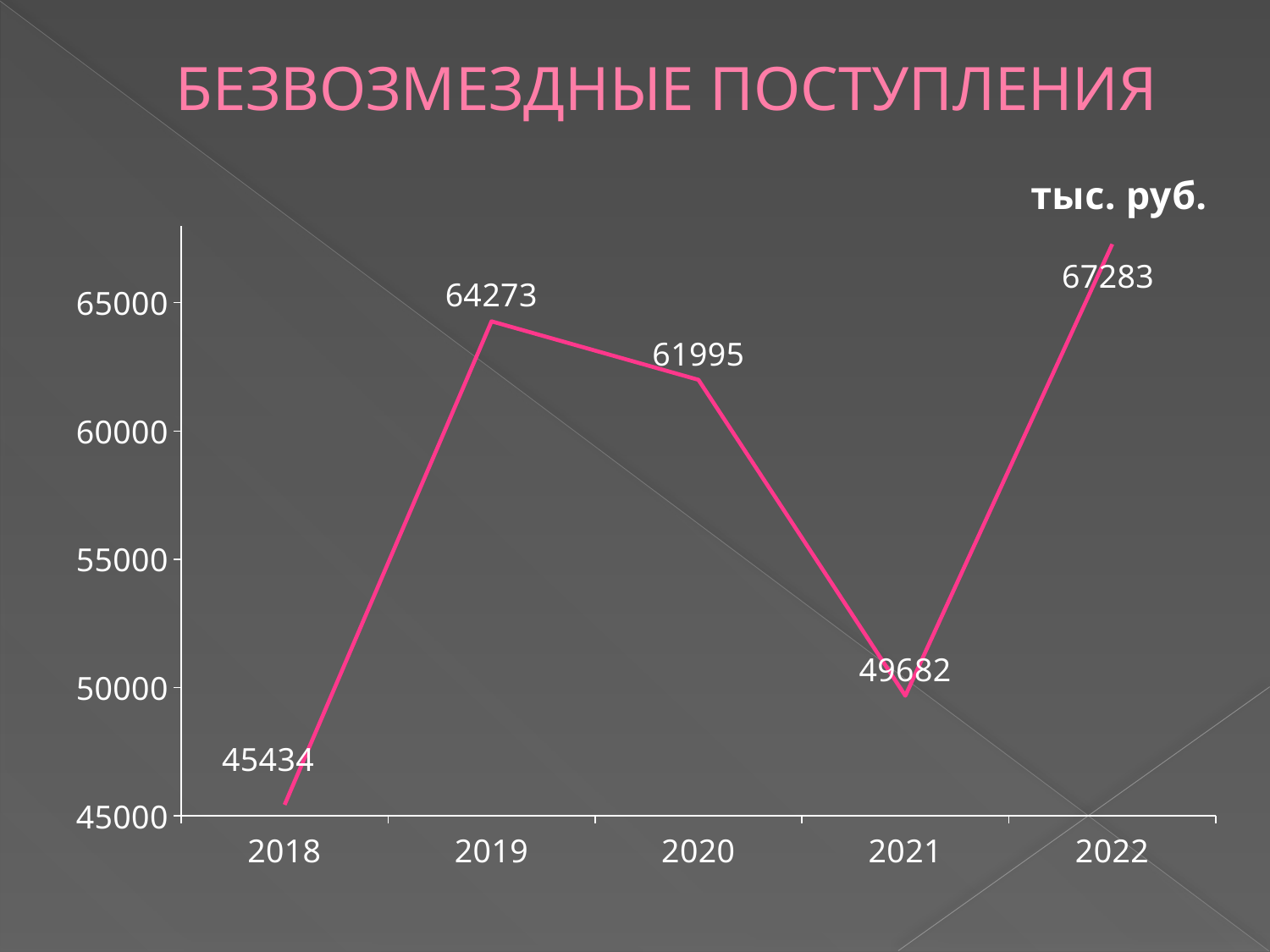
How many years are plotted on the chart? 5 What is the value for 2022? 67283 Is the value for 2021 greater or less than 50000? less What kind of chart is shown on the slide? line chart What is the difference between the values for 2022 and 2021? 17601 What is the value for 2018? 45434 Which year has the highest value? 2022 Which is larger, the value for 2019 or the value for 2020? 2019 Which year has the lowest value? 2018 What is the value for 2021? 49682 What is the difference between the values for 2019 and 2020? 2278 What is the title of the chart? БЕЗВОЗМЕЗДНЫЕ ПОСТУПЛЕНИЯ